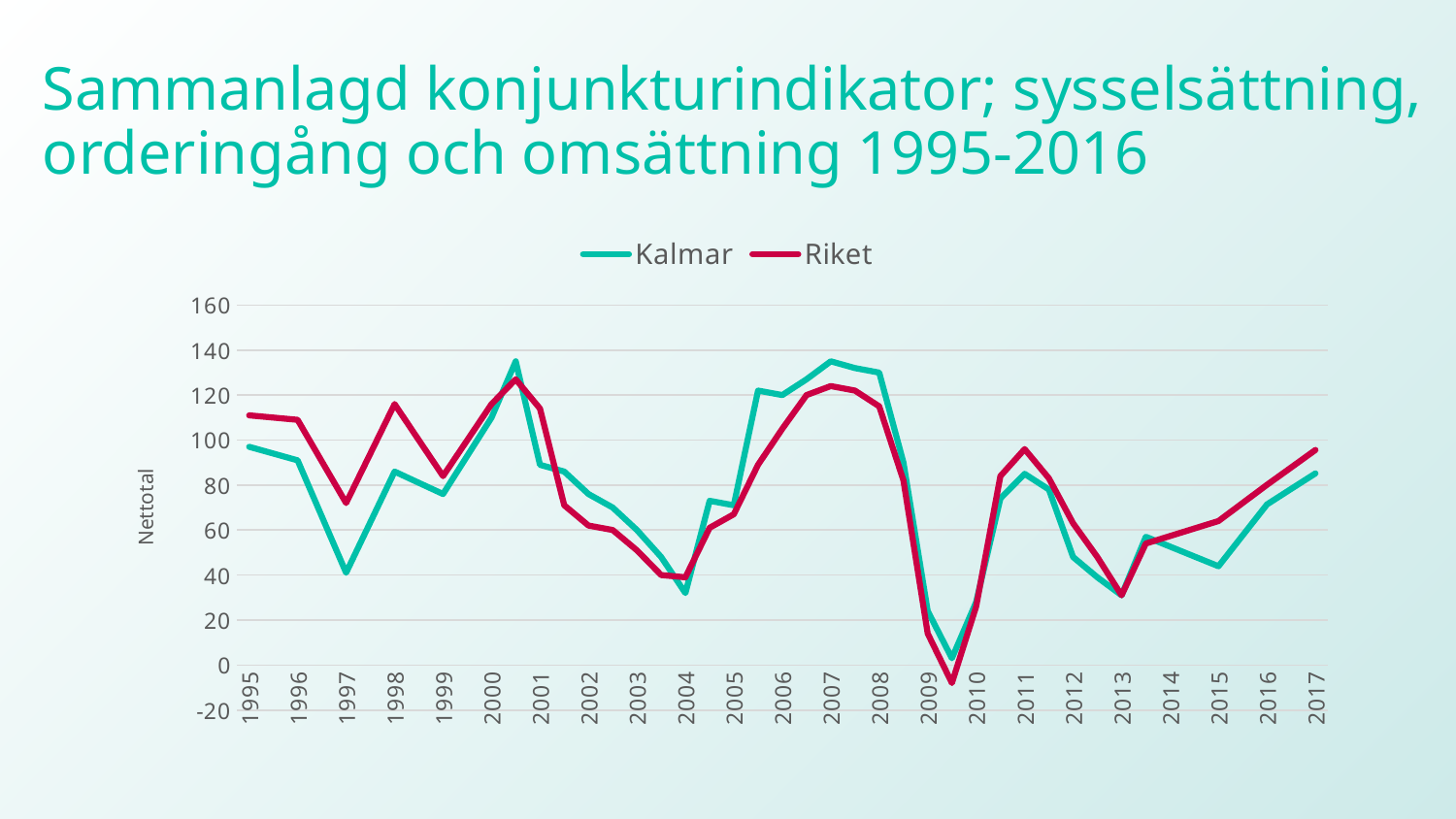
Is the value for Kalmar in 1997 greater or less than 60? less Is the value for Riket in 1998 greater or less than 100? greater Does the Riket line rise or fall between 2013 and 2017? rise What are the two series named in the legend? Kalmar and Riket In 2015, which series has the higher value, Kalmar or Riket? Riket Is the lowest value reached by Riket greater or less than 0? less How many year labels are shown along the x axis? 23 What is the label on the vertical axis? Nettotal What kind of chart is shown on the slide? Line chart How many series does the legend list? 2 In 1997, which series has the higher value, Kalmar or Riket? Riket